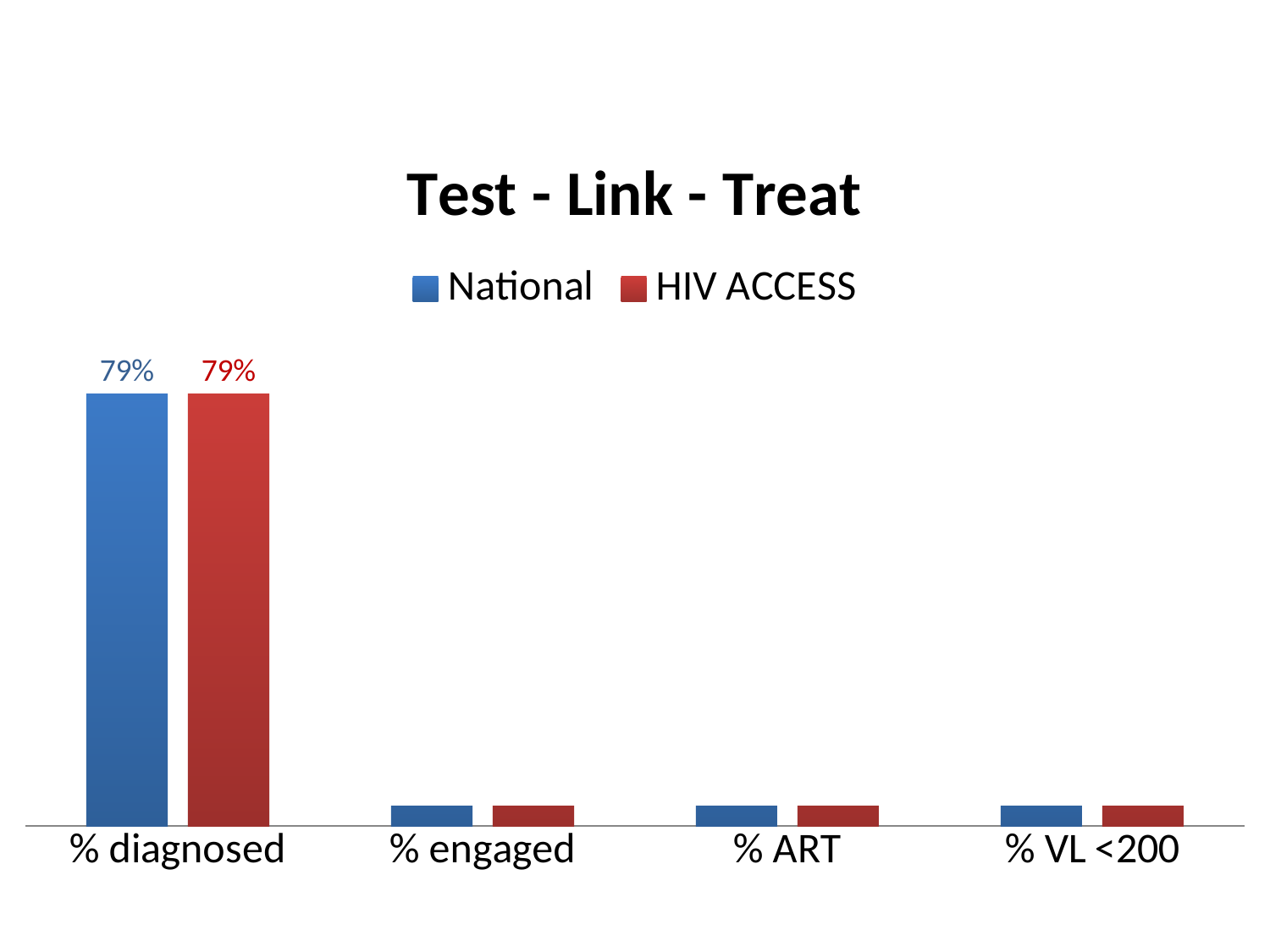
What is the title of the chart? Test - Link - Treat Which series is shown in red in the legend? HIV ACCESS What kind of chart is shown on the slide? Bar chart How many categories are shown on the x axis? 4 What is the HIV ACCESS value for % diagnosed? 79% What is the difference between the National and HIV ACCESS values for % diagnosed? 0% How many series does the legend list? 2 Which is larger for the National series: the value for % diagnosed or the value for % engaged? % diagnosed Do the National values rise or fall from % diagnosed to % engaged? Fall What is the National value for % diagnosed? 79% Which category has the highest bars in the chart? % diagnosed Which is larger for the HIV ACCESS series: the value for % diagnosed or the value for % ART? % diagnosed